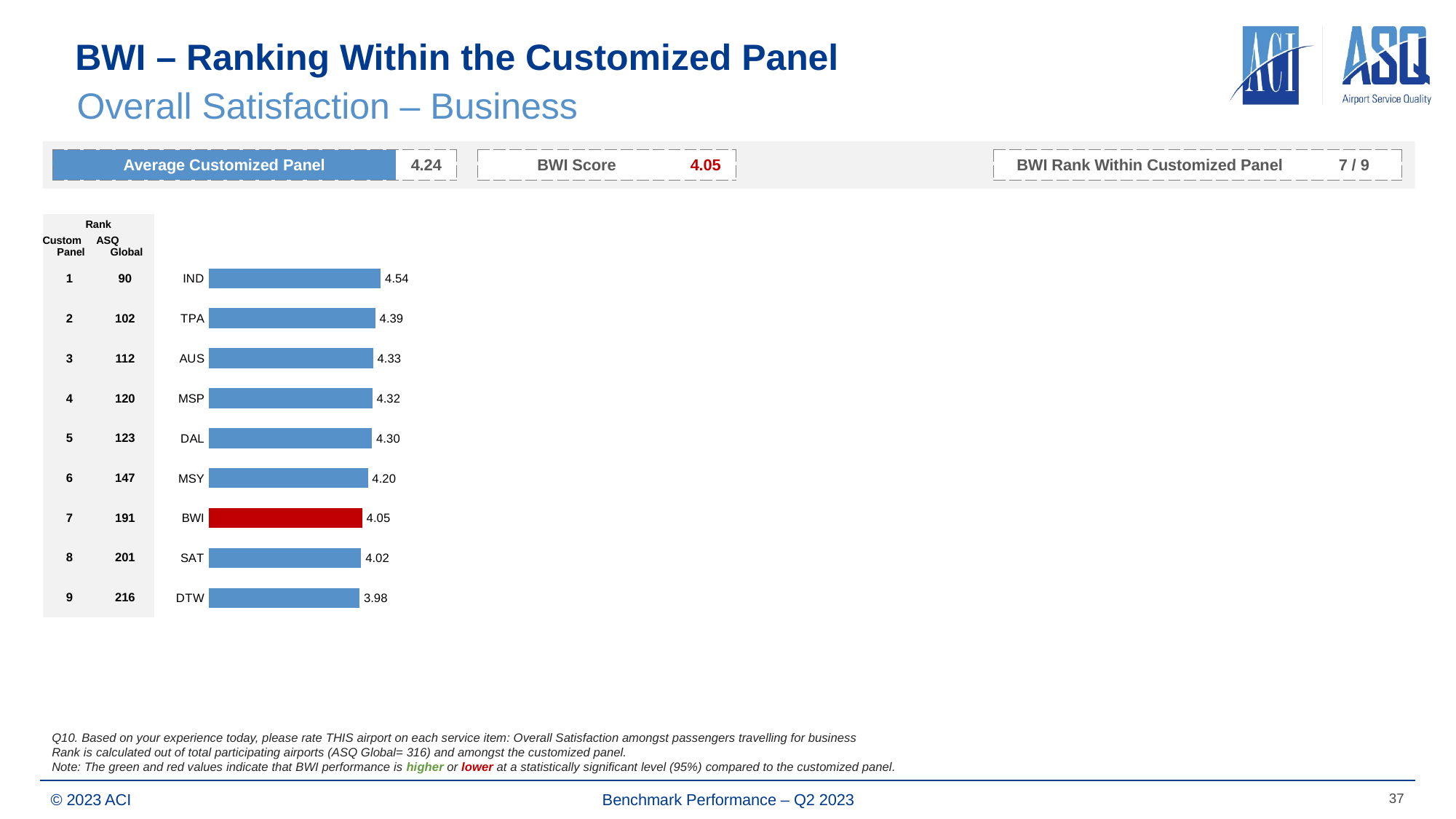
What is the difference between the values for IND and BWI? 0.49 How many airports are shown in the chart? 9 What is the value for BWI? 4.05 Which bar is coloured red in the chart? BWI Which airport has the lowest value? DTW Which airport has the highest value? IND Do the values rise or fall going down the chart from IND to DTW? fall What is the value for DTW? 3.98 What is the difference between the values for TPA and MSY? 0.19 What kind of chart is shown on the slide? bar chart Which is larger, the value for AUS or the value for SAT? AUS What is the value for IND? 4.54